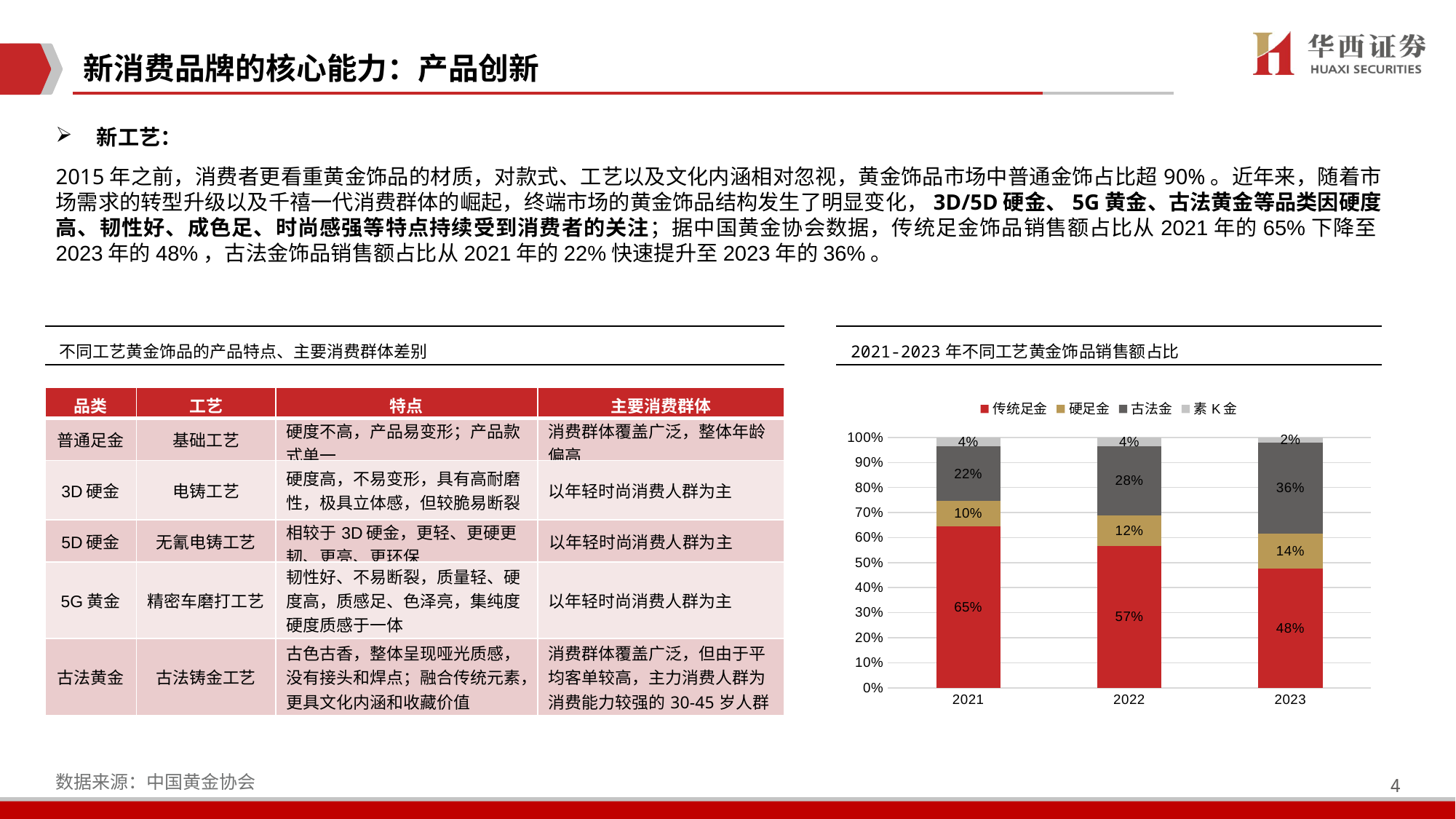
What kind of chart is shown on the right of the slide? Stacked bar chart What is the value for 素K金 in 2023? 2% Which is larger in 2022: the share of 古法金 or the share of 硬足金? 古法金 How does the share of 古法金 change from 2021 to 2023? It rises How many series does the legend list? 4 By how many percentage points did the share of 传统足金 fall from 2021 to 2023? 17% In which year is the share of 古法金 the highest? 2023 What is the value for 传统足金 in 2021? 65% In which year is the share of 传统足金 the lowest? 2023 How many years are shown on the x axis? 3 What is the value for 古法金 in 2023? 36% What is the value for 硬足金 in 2022? 12%